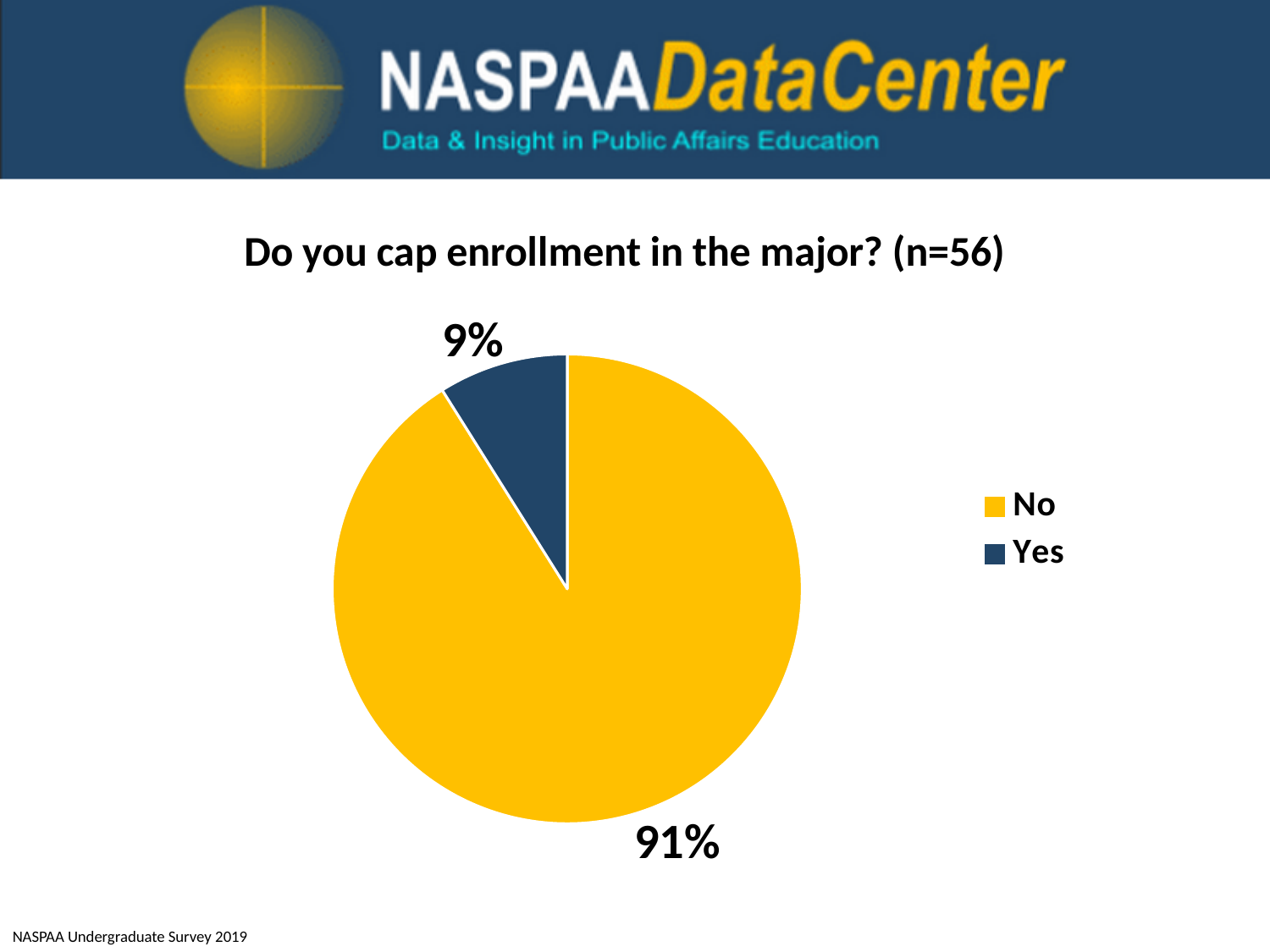
How many entries does the legend list? 2 Which response has the largest share of the pie? No What colour is the "No" slice in the pie chart? Yellow Which response has the smallest share of the pie? Yes How many slices does the pie chart have? 2 What share of the pie does the "Yes" slice represent? 9% What is the title of the chart? Do you cap enrollment in the major? (n=56) Which is larger, the share for "Yes" or the share for "No"? No What kind of chart is shown on the slide? Pie chart What percentage of respondents answered "No" to capping enrollment in the major? 91% What percentage of respondents answered "Yes" to capping enrollment in the major? 9% What is the difference in percentage points between the "No" and "Yes" shares? 82